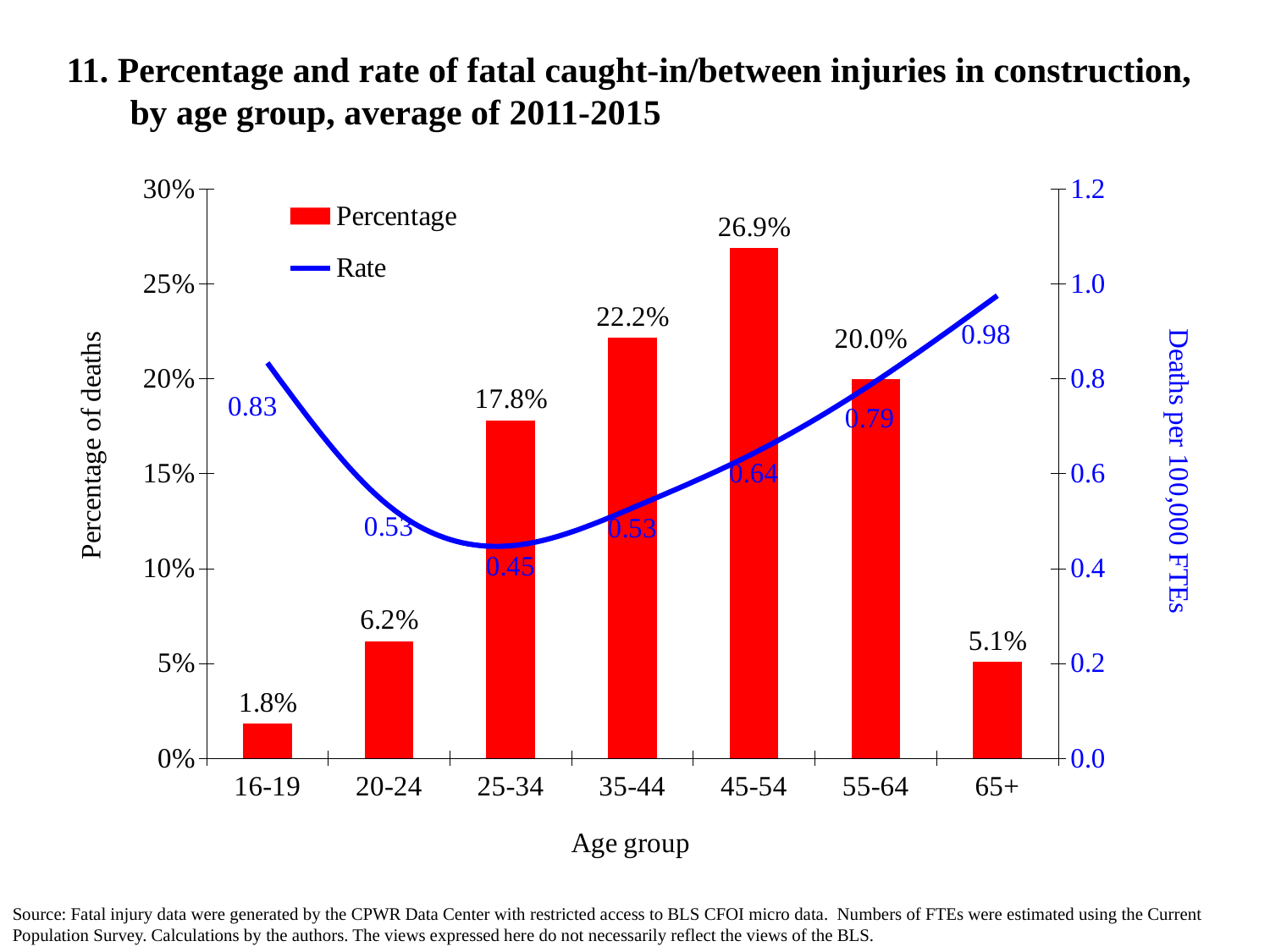
What is the rate (deaths per 100,000 FTEs) for the 16-19 age group? 0.83 Which is larger, the rate for the 55-64 age group or the rate for the 45-54 age group? 55-64 Does the rate rise or fall from the 25-34 age group to the 65+ age group? rise What is the percentage of deaths for the 65+ age group? 5.1% What is the label of the right-hand vertical axis? Deaths per 100,000 FTEs What is the percentage of deaths for the 45-54 age group? 26.9% What is the difference in percentage of deaths between the 45-54 and 55-64 age groups? 6.9% Which age group has the lowest rate of deaths per 100,000 FTEs? 25-34 Which age group has the lowest percentage of deaths? 16-19 How many age groups are shown on the x axis? 7 How many series does the legend list? 2 Which age group has the highest percentage of deaths? 45-54